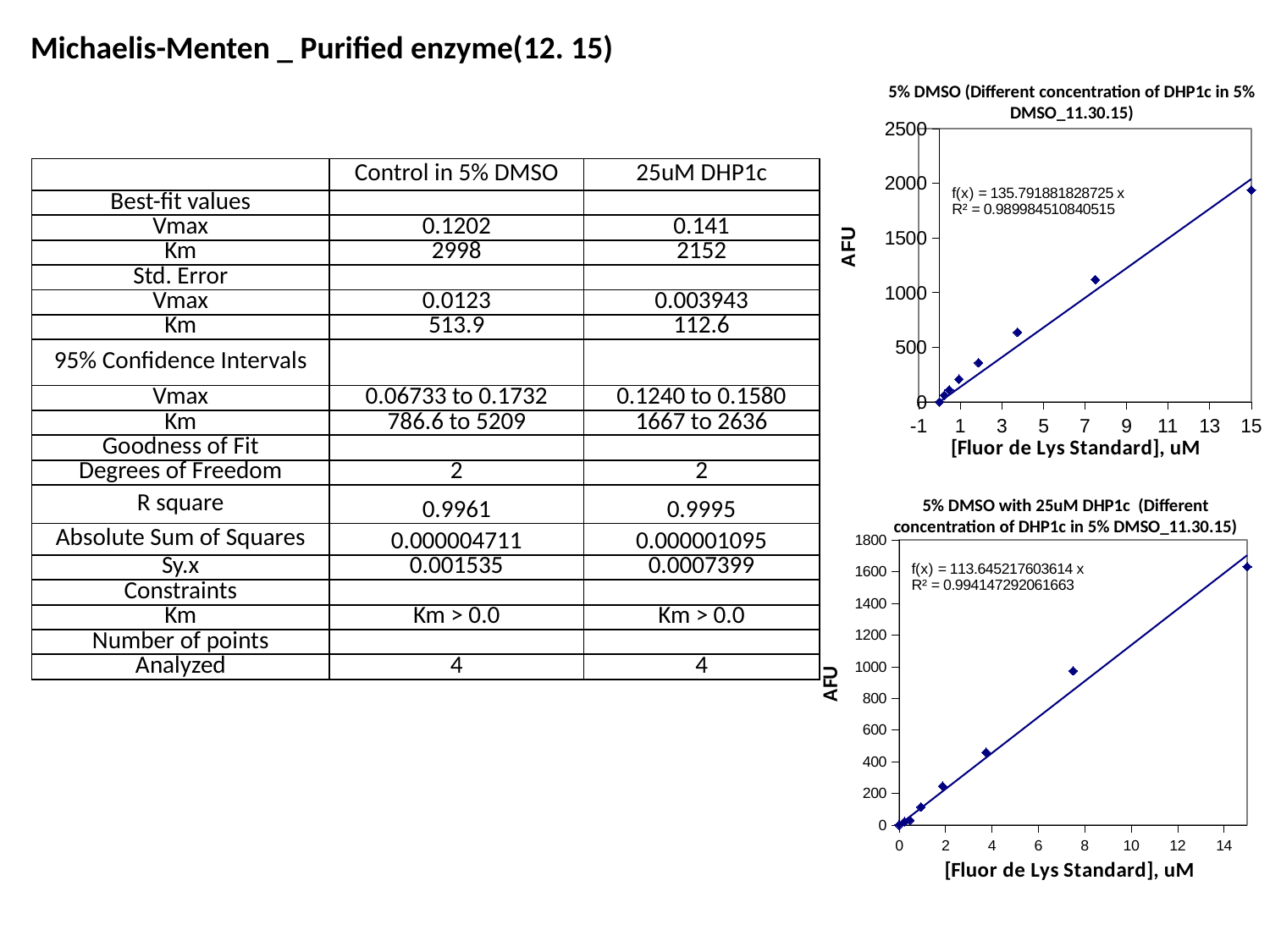
In the bottom chart, do the AFU values rise or fall as the Fluor de Lys Standard concentration increases? Rise What kind of chart is the bottom chart titled '5% DMSO with 25uM DHP1c'? Scatter chart with a linear trendline In the bottom chart, is the AFU value at 15 uM greater or less than 1400? greater What is the trendline equation shown on the top chart? f(x) = 135.791881828725 x Which chart has the larger trendline slope, the top chart or the bottom chart? The top chart In the top chart, do the AFU values rise or fall as the Fluor de Lys Standard concentration increases? Rise In the top chart, is the AFU value at about 7.5 uM greater or less than 1500? less In the bottom chart, is the AFU value at about 7.5 uM greater or less than 800? greater What R² value is shown on the bottom chart? R² = 0.994147292061663 What kind of chart is the top chart titled '5% DMSO (Different concentration of DHP1c in 5% DMSO_11.30.15)'? Scatter chart with a linear trendline